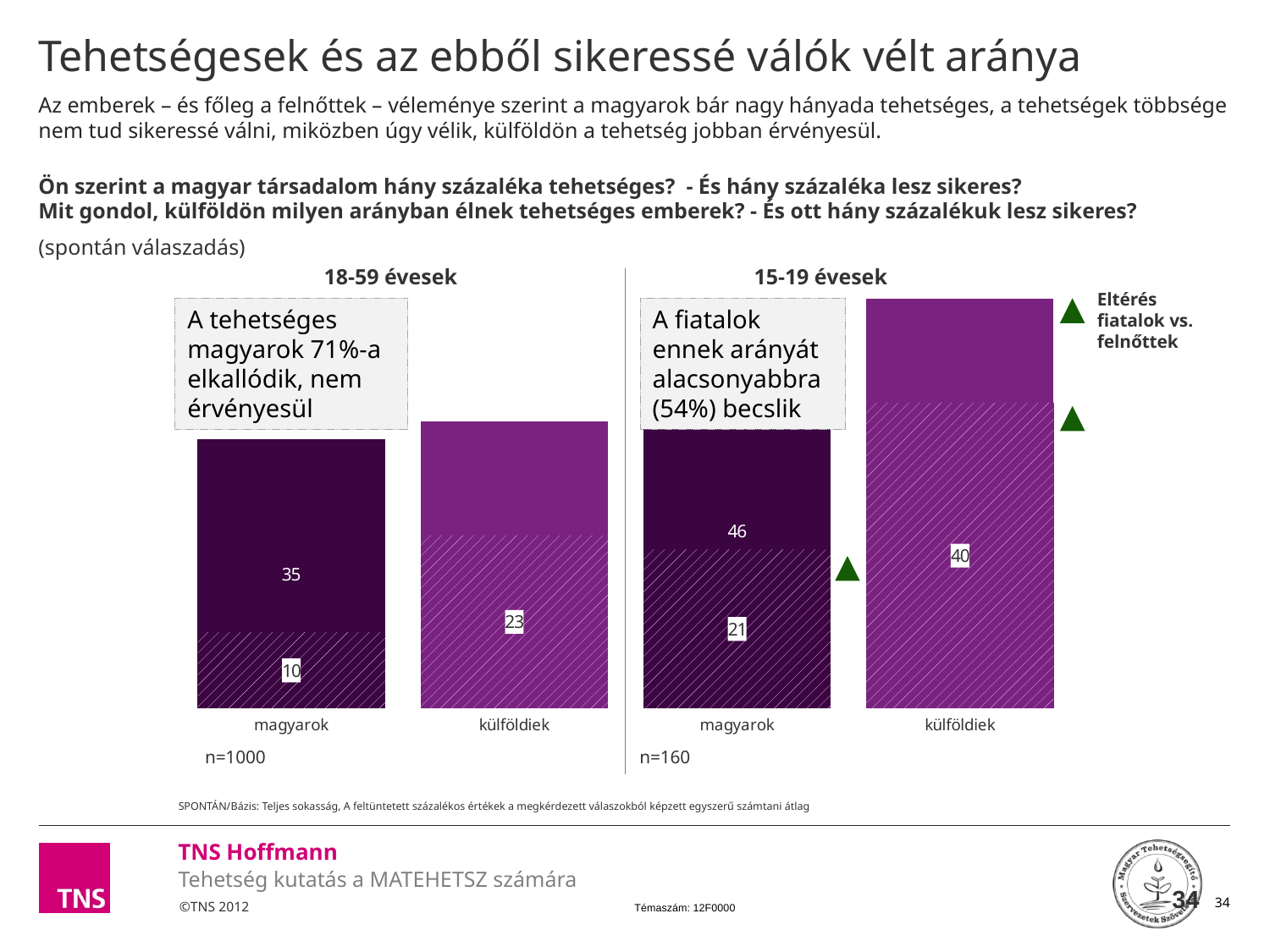
In the 15-19 évesek chart, what value is printed on the solid (upper) part of the magyarok bar? 46 In the 18-59 évesek chart, what value is printed on the hatched part of the magyarok bar? 10 What kind of chart is used for the 15-19 évesek data? bar chart In the 18-59 évesek chart, what value is printed on the hatched part of the külföldiek bar? 23 In the 15-19 évesek chart, which hatched value is larger, magyarok or külföldiek? külföldiek What sample size (n) is shown under the 15-19 évesek chart? n=160 In the 15-19 évesek chart, what value is printed on the hatched part of the magyarok bar? 21 What is the difference between the magyarok solid value in the 15-19 évesek chart (46) and in the 18-59 évesek chart (35)? 11 What is the difference between the külföldiek hatched value in the 15-19 évesek chart (40) and in the 18-59 évesek chart (23)? 17 How many categories are shown on the x axis of the 18-59 évesek chart? 2 In the 15-19 évesek chart, what value is printed on the hatched part of the külföldiek bar? 40 In the 18-59 évesek chart, what value is printed on the solid (upper) part of the magyarok bar? 35